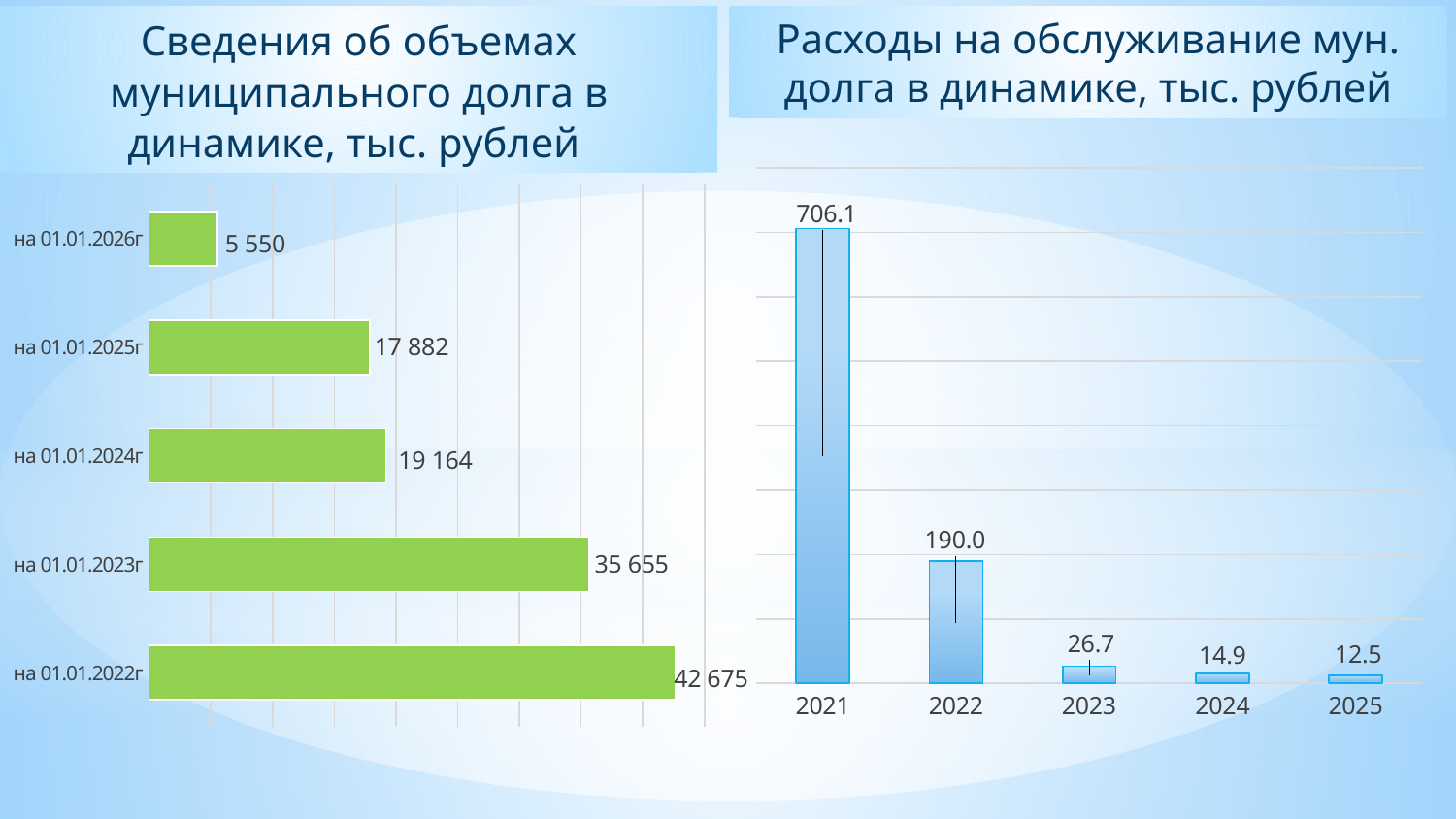
In the left chart (Сведения об объемах муниципального долга), what is the difference between the values for на 01.01.2023г and на 01.01.2025г? 17 773 In the right chart (Расходы на обслуживание мун. долга), do the values rise or fall from 2021 to 2025? Fall In the right chart (Расходы на обслуживание мун. долга), which year has the highest value? 2021 In the left chart (Сведения об объемах муниципального долга), what is the value for на 01.01.2026г? 5 550 In the left chart (Сведения об объемах муниципального долга), how many categories are shown? 5 In the right chart (Расходы на обслуживание мун. долга), what is the value for 2024? 14.9 In the left chart (Сведения об объемах муниципального долга), what is the value for на 01.01.2024г? 19 164 What kind of chart is the left chart (Сведения об объемах муниципального долга)? Bar chart In the left chart (Сведения об объемах муниципального долга), which category has the highest value? на 01.01.2022г In the left chart (Сведения об объемах муниципального долга), which category has the lowest value? на 01.01.2026г In the right chart (Расходы на обслуживание мун. долга), what is the difference between the values for 2021 and 2022? 516.1 In the right chart (Расходы на обслуживание мун. долга), what is the value for 2022? 190.0